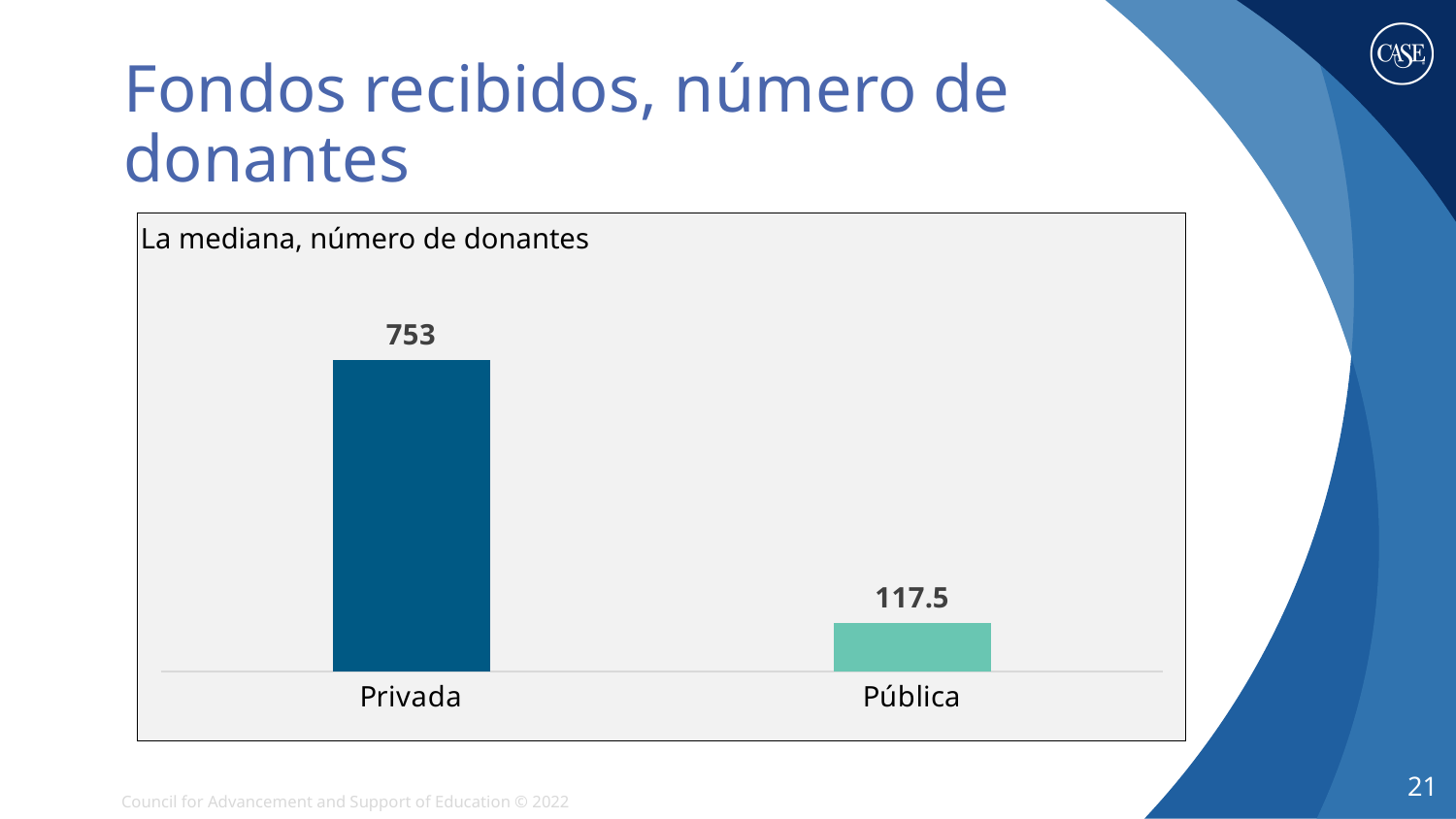
What is the title of the chart? La mediana, número de donantes What is the difference between the median number of donors for Privada and Pública? 635.5 What colour is the bar for Pública? Teal (light green) What kind of chart is shown on the slide? Bar chart Which category has the highest median number of donors? Privada How many categories are shown in the chart? 2 Which category has the lowest median number of donors? Pública What is the median number of donors for Privada? 753 Which is larger, the value for Privada or the value for Pública? Privada What is the median number of donors for Pública? 117.5